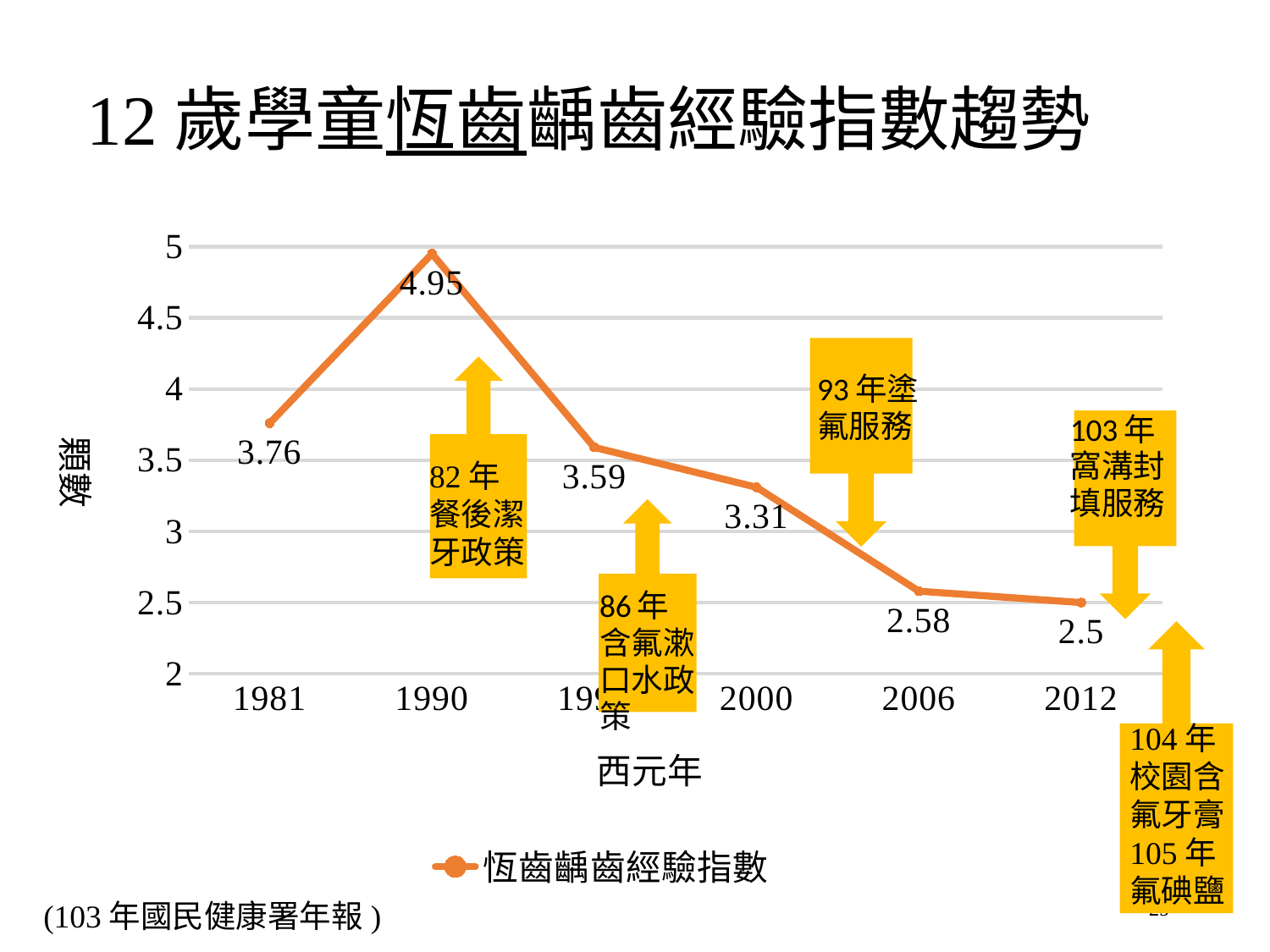
Which year has the highest value? 1990 What is the difference between the values for 1990 and 2012? 2.45 Which is larger, the value for 1981 or the value for 2000? 1981 How many data points are plotted on the line? 6 What kind of chart is shown? line chart What is the value for 1990? 4.95 What is the value for 1981? 3.76 What is the value for 2006? 2.58 Do the values rise or fall from 1990 to 2012? fall Which year has the lowest value? 2012 What is the value for 2000? 3.31 What is the value for 2012? 2.5